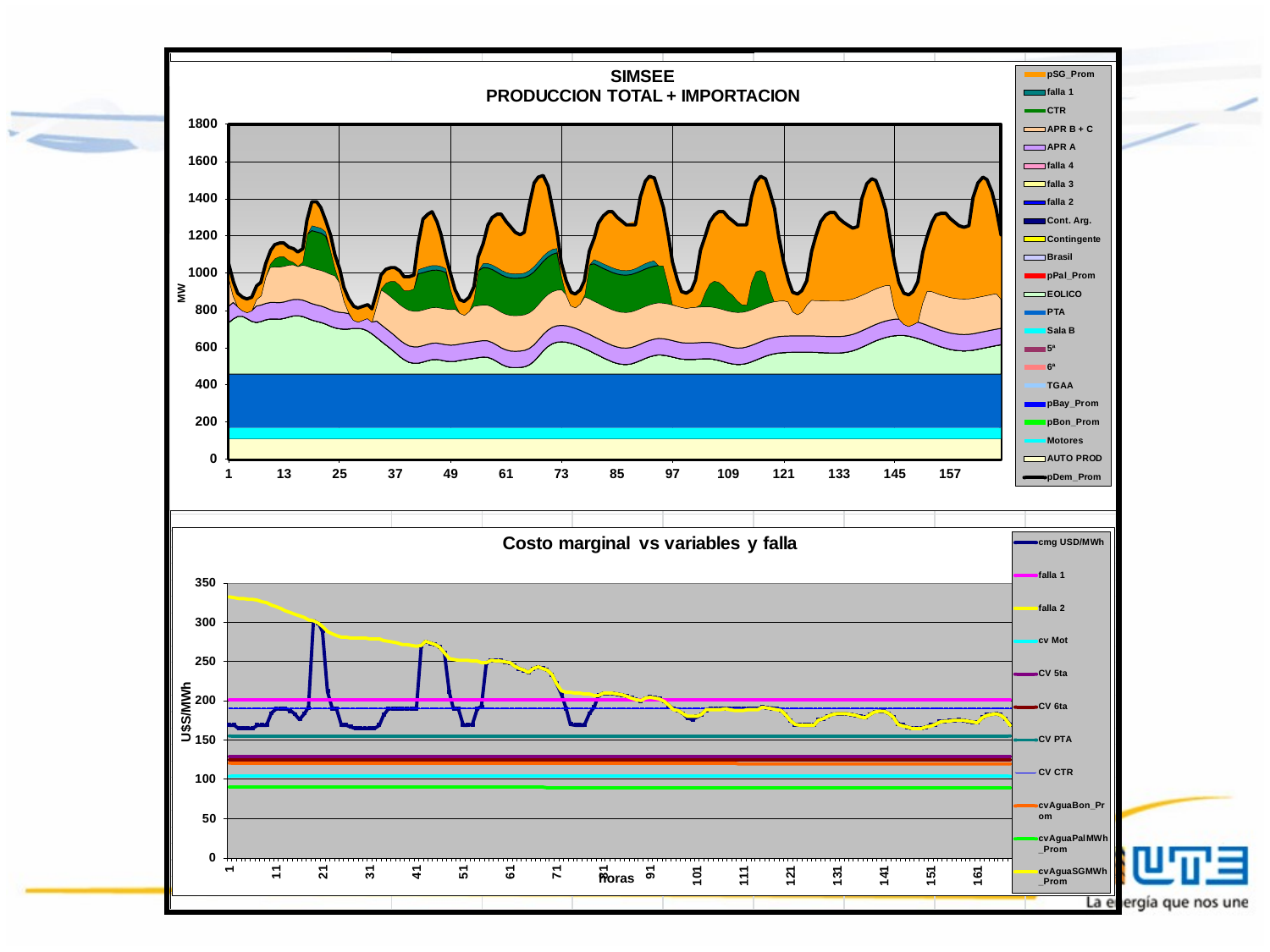
In the top chart (SIMSEE PRODUCCION TOTAL + IMPORTACION), what is the maximum value shown on the MW axis? 1800 In the bottom chart (Costo marginal vs variables y falla), is the value of cvAguaSGMWh_Prom at hour 1 greater or less than 300? greater How many series does the legend of the top chart (SIMSEE PRODUCCION TOTAL + IMPORTACION) list? 23 In the top chart (SIMSEE PRODUCCION TOTAL + IMPORTACION), what kind of chart is used? Stacked area chart In the bottom chart (Costo marginal vs variables y falla), is the cvAguaPalMWh_Prom line greater or less than 100? less In the bottom chart (Costo marginal vs variables y falla), is the peak value of cmg USD/MWh near hour 21 greater or less than 250? greater In the bottom chart (Costo marginal vs variables y falla), what kind of chart is used? Line chart In the bottom chart (Costo marginal vs variables y falla), does the cvAguaSGMWh_Prom line rise or fall along the x axis? Fall What is the title of the top chart? SIMSEE PRODUCCION TOTAL + IMPORTACION What is the title of the bottom chart? Costo marginal vs variables y falla How many series does the legend of the bottom chart (Costo marginal vs variables y falla) list? 11